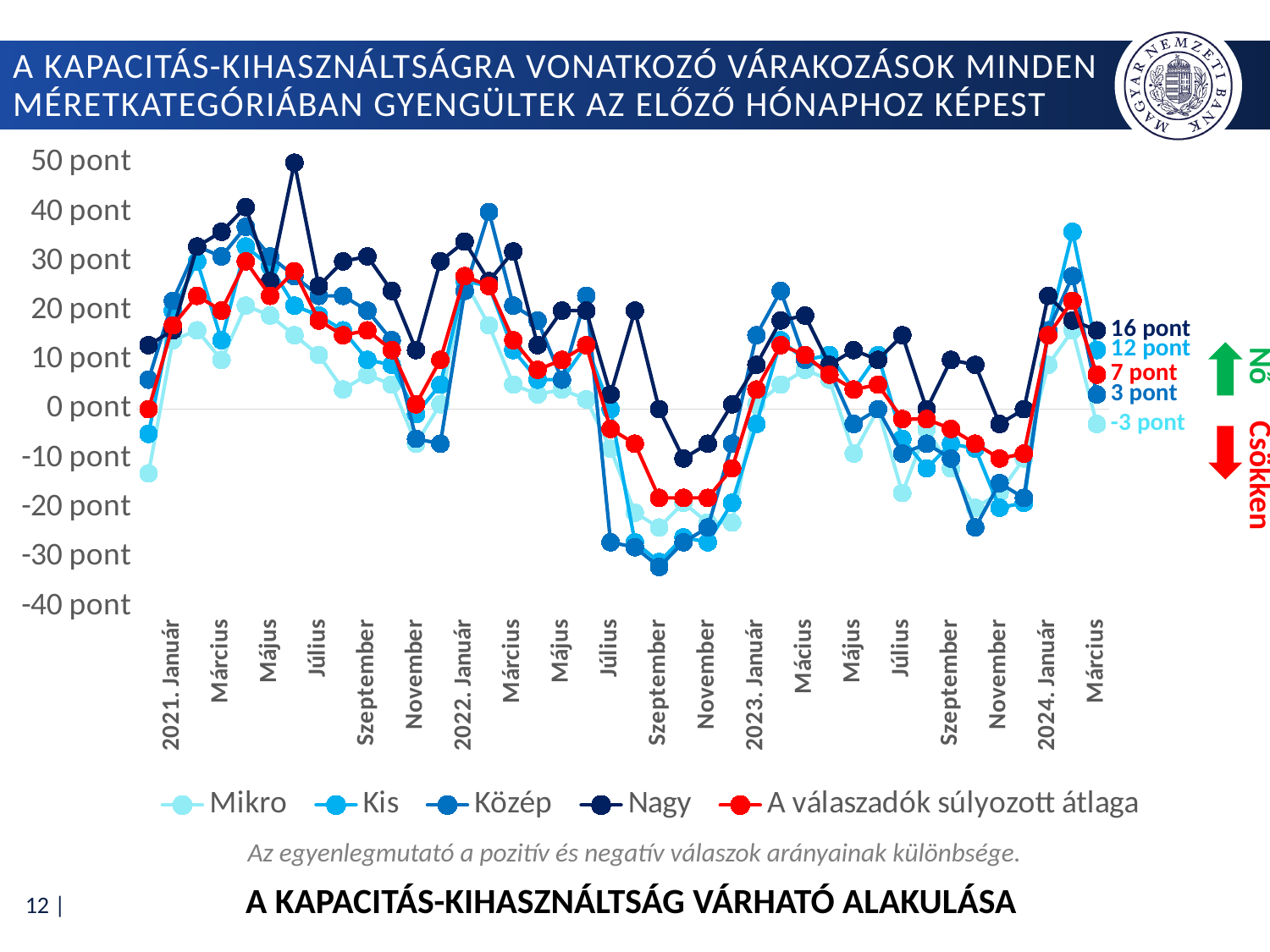
What colour is the line for A válaszadók súlyozott átlaga? red What is the latest value shown for the Mikro series? -3 pont Which series has the highest value at the last data point (2024. Március)? Nagy What is the difference between the latest values of Nagy and Mikro? 19 pont At the last data point, which is larger: Kis or Közép? Kis Is the value for A válaszadók súlyozott átlaga in 2022. Szeptember greater or less than -10 pont? less What is the latest value shown for the Kis series? 12 pont Which series has the lowest value at the last data point (2024. Március)? Mikro What kind of chart is shown on the slide? line chart How many series does the legend list? 5 What is the latest value shown for A válaszadók súlyozott átlaga? 7 pont What is the latest value shown for the Nagy series? 16 pont